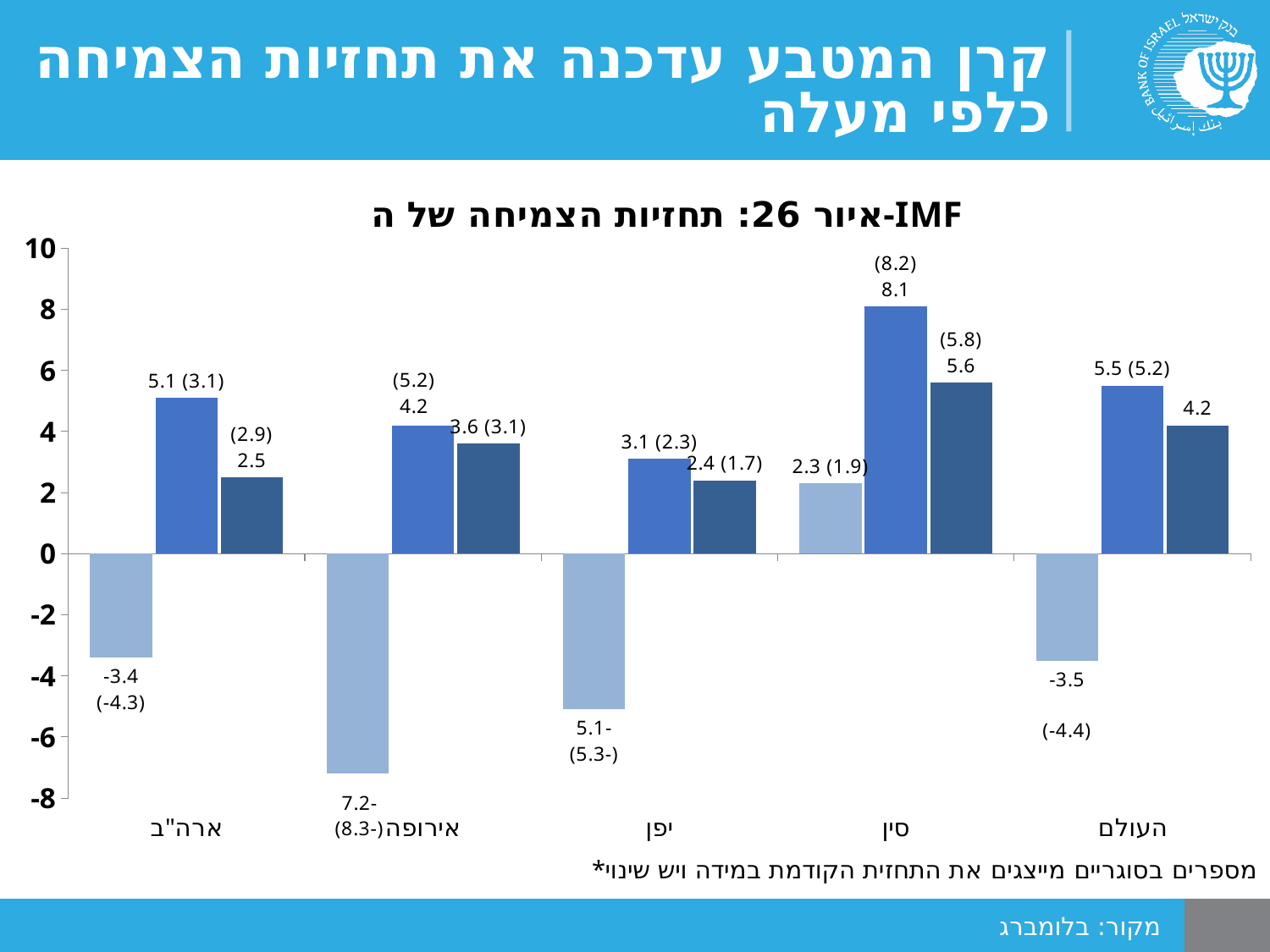
Which is larger: the dark blue (third) bar for סין or the dark blue bar for העולם? סין Which category has the lowest value among the light blue (first) bars? אירופה How many categories (countries/regions) are shown on the x axis of the chart? 5 What is the value of the light blue (first) bar for אירופה (Europe)? -7.2 What is the difference between the middle (medium blue) bar for סין (8.1) and the middle bar for יפן (3.1)? 5 What is the previous forecast shown in parentheses for the middle (medium blue) bar of ארה"ב? 3.1 What is the value of the light blue (first) bar for ארה"ב (USA)? -3.4 What is the value of the middle (medium blue) bar for סין (China)? 8.1 What type of chart is shown on the slide? bar chart What is the value of the dark blue (third) bar for העולם (World)? 4.2 Which category has the highest value among the middle (medium blue) bars? סין What is the title of the chart? איור 26: תחזיות הצמיחה של ה-IMF